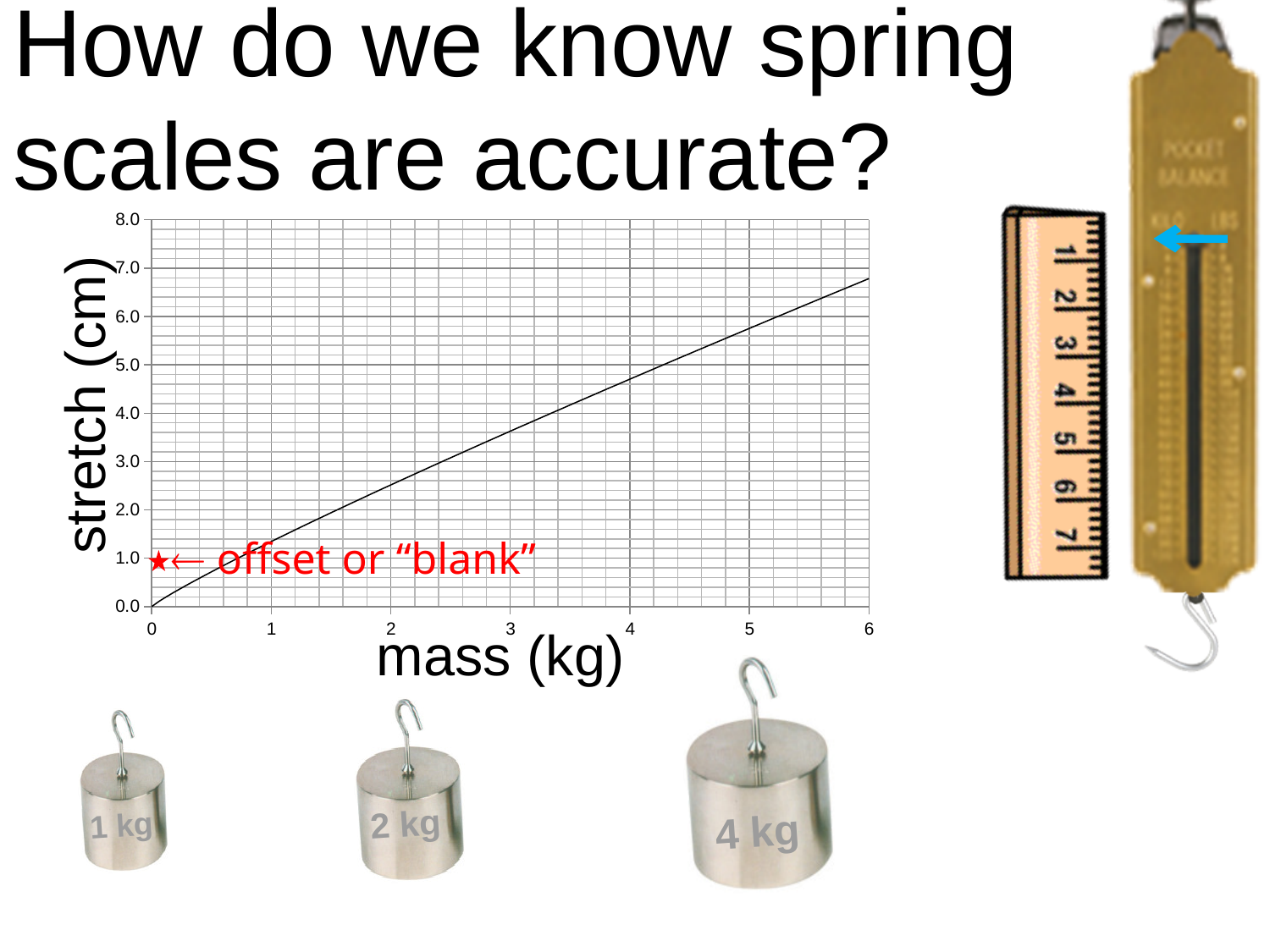
Is the stretch at a mass of 1 kg greater or less than 1.0 cm? greater Is the stretch at a mass of 3 kg greater or less than 3.0 cm? greater Is the stretch at a mass of 3 kg greater or less than 4.0 cm? less What is the highest value shown on the vertical axis of the chart? 8.0 What is the label of the horizontal axis of the chart? mass (kg) What kind of chart is shown on the slide? line chart What is the label of the vertical axis of the chart? stretch (cm) Does the stretch rise or fall as mass increases along the x axis? rise At which mass value on the x axis is the stretch highest? 6